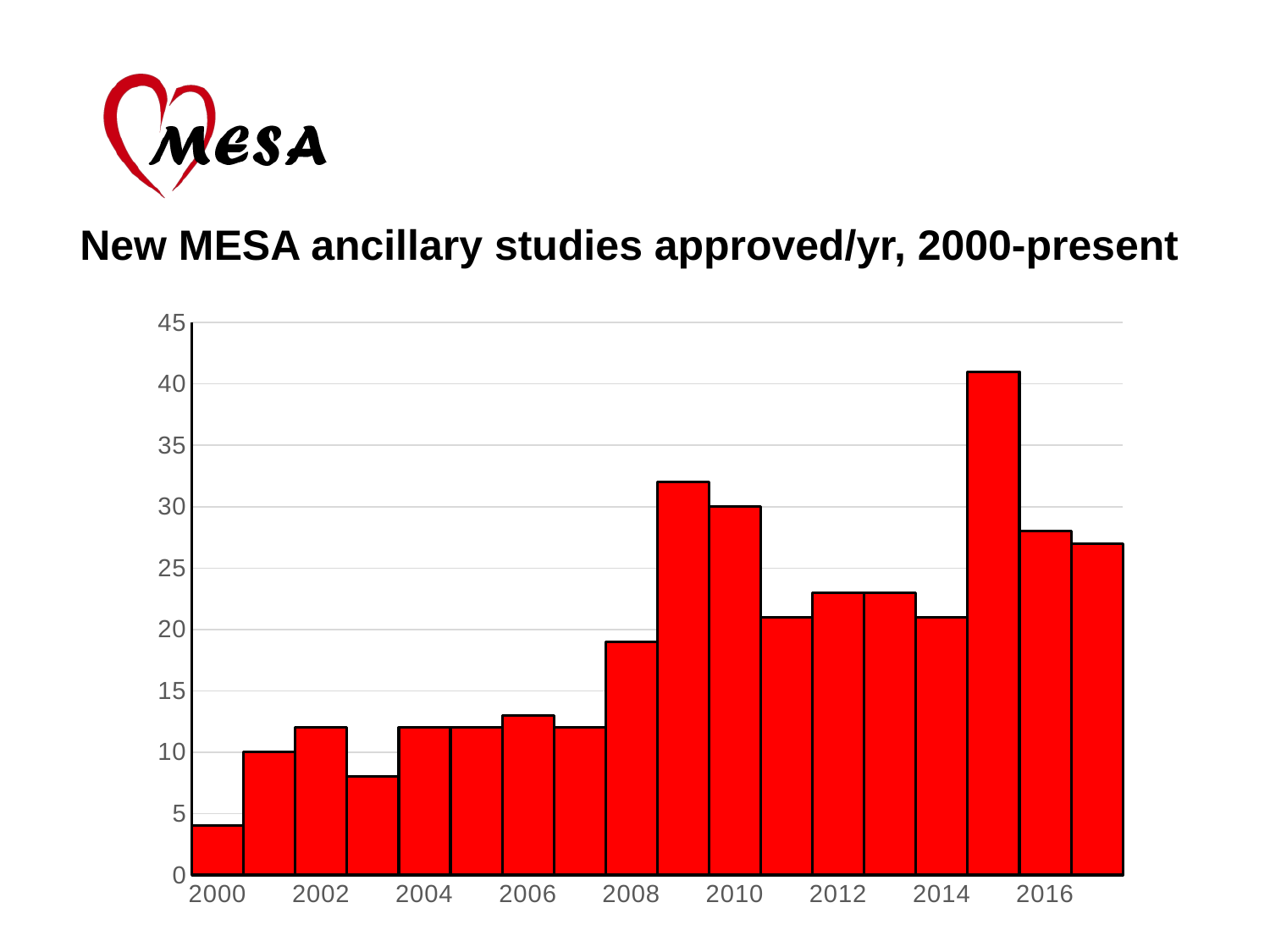
Is the value for 2016 greater or less than 25? greater What kind of chart is shown on the slide? bar chart Is the value for 2015 greater or less than 40? greater Which year has a larger value, 2008 or 2009? 2009 Which year has the highest number of new ancillary studies approved? 2015 What is the title of the chart? New MESA ancillary studies approved/yr, 2000-present Is the value for 2008 greater or less than 20? less Which year has the lowest number of new ancillary studies approved? 2000 Which year has a larger value, 2015 or 2016? 2015 Do the values rise or fall from 2000 to 2002? rise How many bars (years) are plotted in the chart? 18